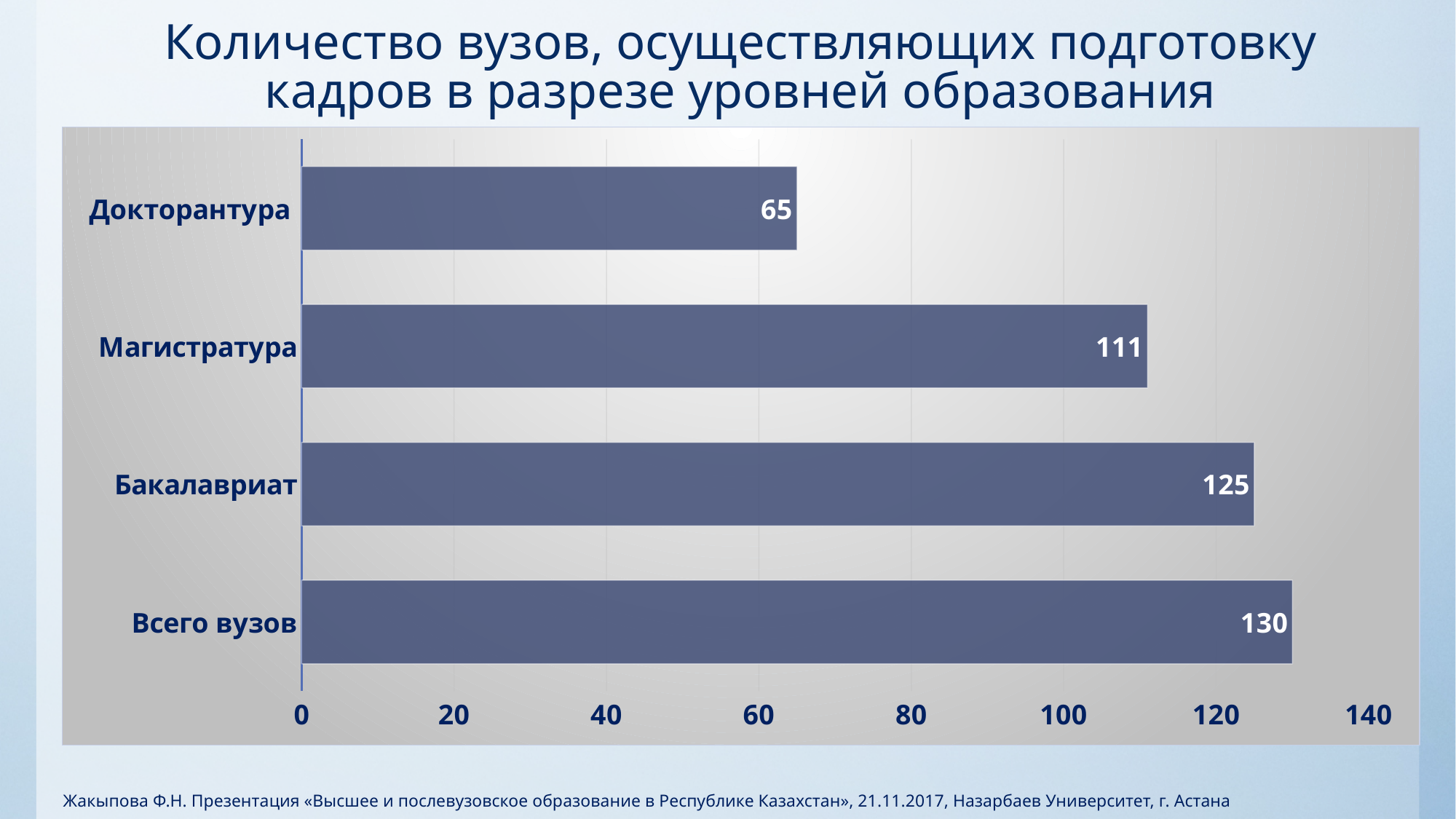
What is the value for Бакалавриат? 125 What is the difference between the values for Бакалавриат and Магистратура? 14 What is the value for Магистратура? 111 What is the value for Докторантура? 65 How many categories are shown in the chart? 4 What is the difference between the values for Всего вузов and Докторантура? 65 Which is larger, the value for Магистратура or the value for Докторантура? Магистратура What is the value for Всего вузов? 130 What is the title of the chart? Количество вузов, осуществляющих подготовку кадров в разрезе уровней образования What kind of chart is shown on the slide? Bar chart Which category has the lowest value? Докторантура Which category has the highest value? Всего вузов